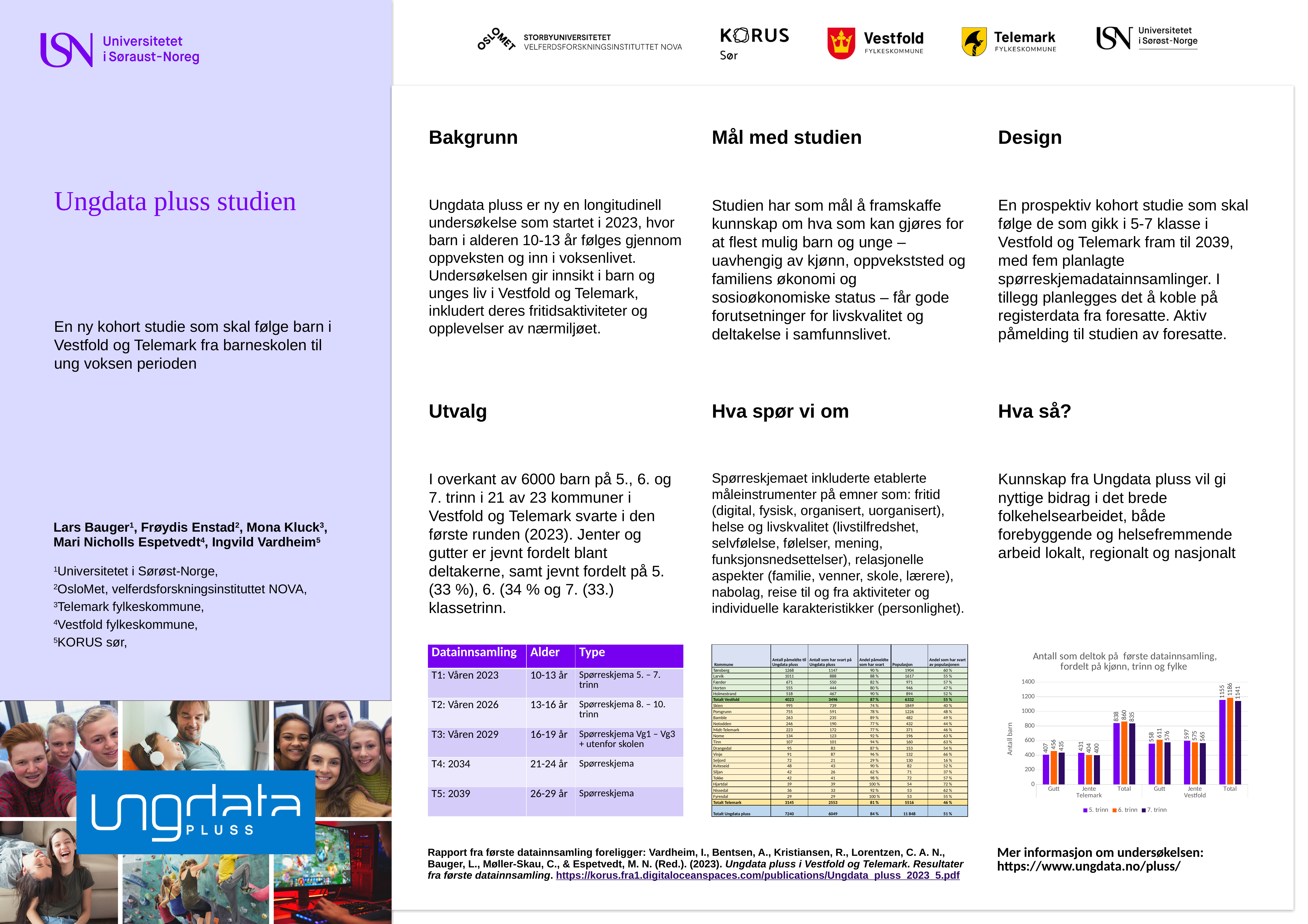
Which is larger: the 5. trinn value for Jente in Vestfold or the 5. trinn value for Gutt in Vestfold? Jente Vestfold What type of chart is shown on the slide? bar chart How many series does the chart legend list? 3 Which category has the lowest value for 5. trinn? Gutt Telemark What is the label of the y axis of the chart? Antall barn What is the value for 5. trinn for Gutt in Telemark? 407 What is the value for 7. trinn for Jente in Vestfold? 565 Is the 7. trinn value for Total in Telemark greater or less than 1000? less What is the difference between the 6. trinn values for Gutt in Vestfold and Gutt in Telemark? 155 What is the value for 6. trinn for Total in Vestfold? 1186 What is the title of the chart on the slide? Antall som deltok på første datainnsamling, fordelt på kjønn, trinn og fylke Which category has the highest value for 6. trinn? Total Vestfold